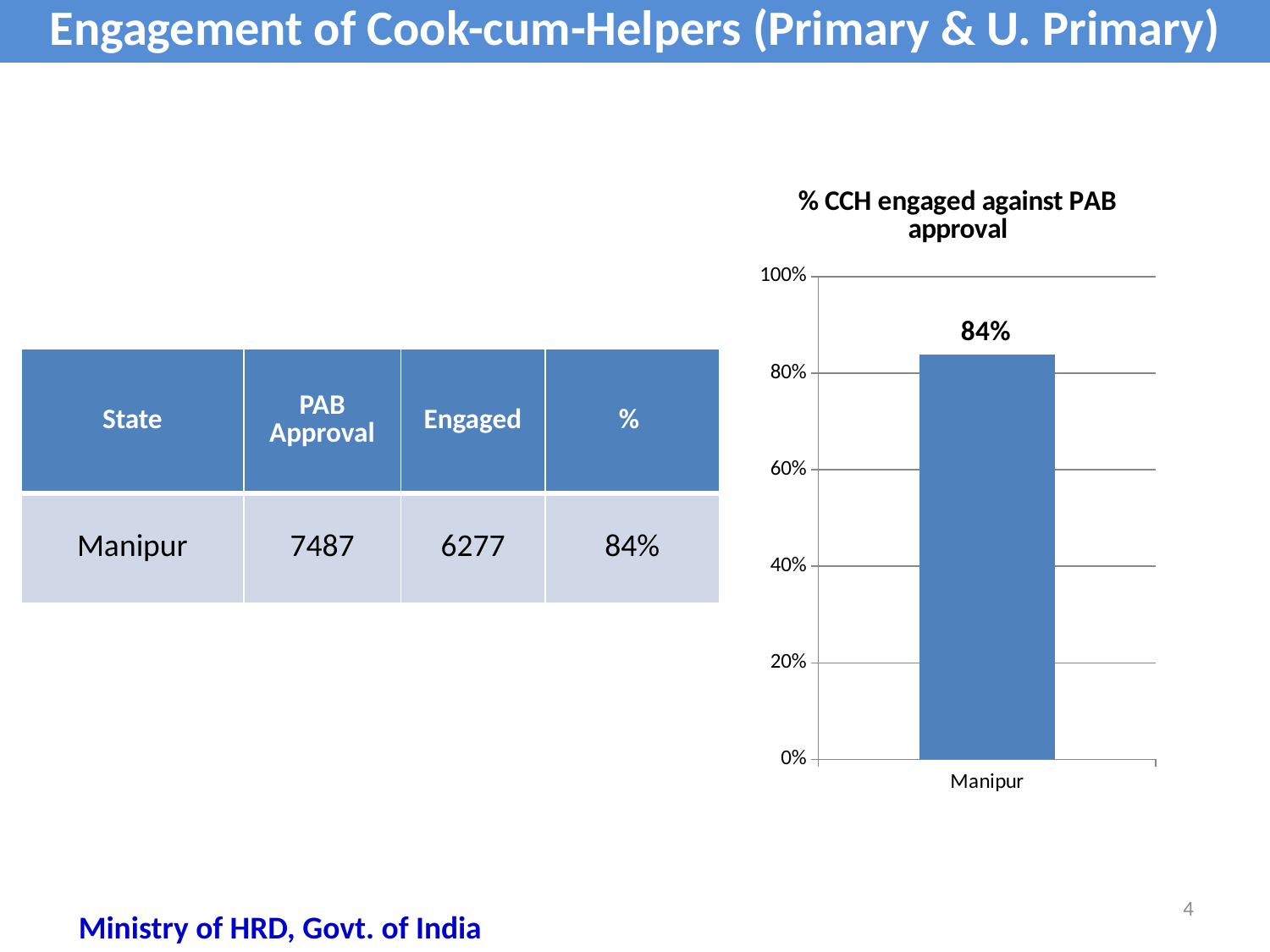
Is the value for Manipur greater or less than 80%? greater What kind of chart is shown on the slide? bar chart Is the value for Manipur greater or less than 100%? less How many categories are plotted in the chart? 1 Which state is shown on the x axis of the chart? Manipur What is the title of the chart? % CCH engaged against PAB approval What is the value for Manipur in the chart? 84% What is the highest value shown on the chart's y axis? 100%